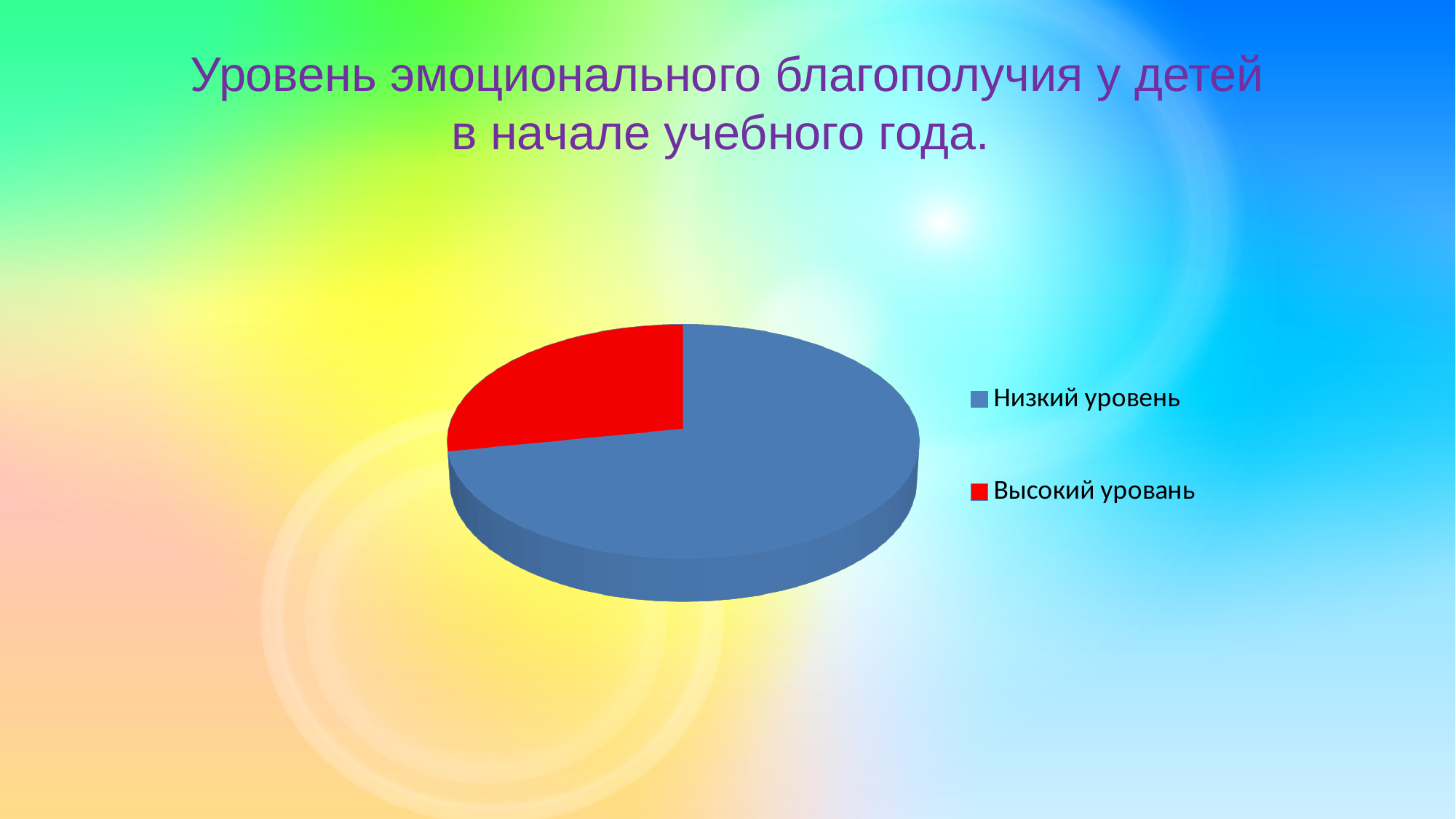
What colour is the slice for Низкий уровень? blue How many entries does the legend of the pie chart list? 2 What is the title of the slide containing the pie chart? Уровень эмоционального благополучия у детей в начале учебного года. Which slice is larger: Низкий уровень or Высокий уровань? Низкий уровень Which category has the largest slice of the pie chart? Низкий уровень How many slices does the pie chart have? 2 What kind of chart is shown on the slide? pie chart Which category has the smallest slice of the pie chart? Высокий уровань Does the slice for Высокий уровань take up more or less than half of the pie? less